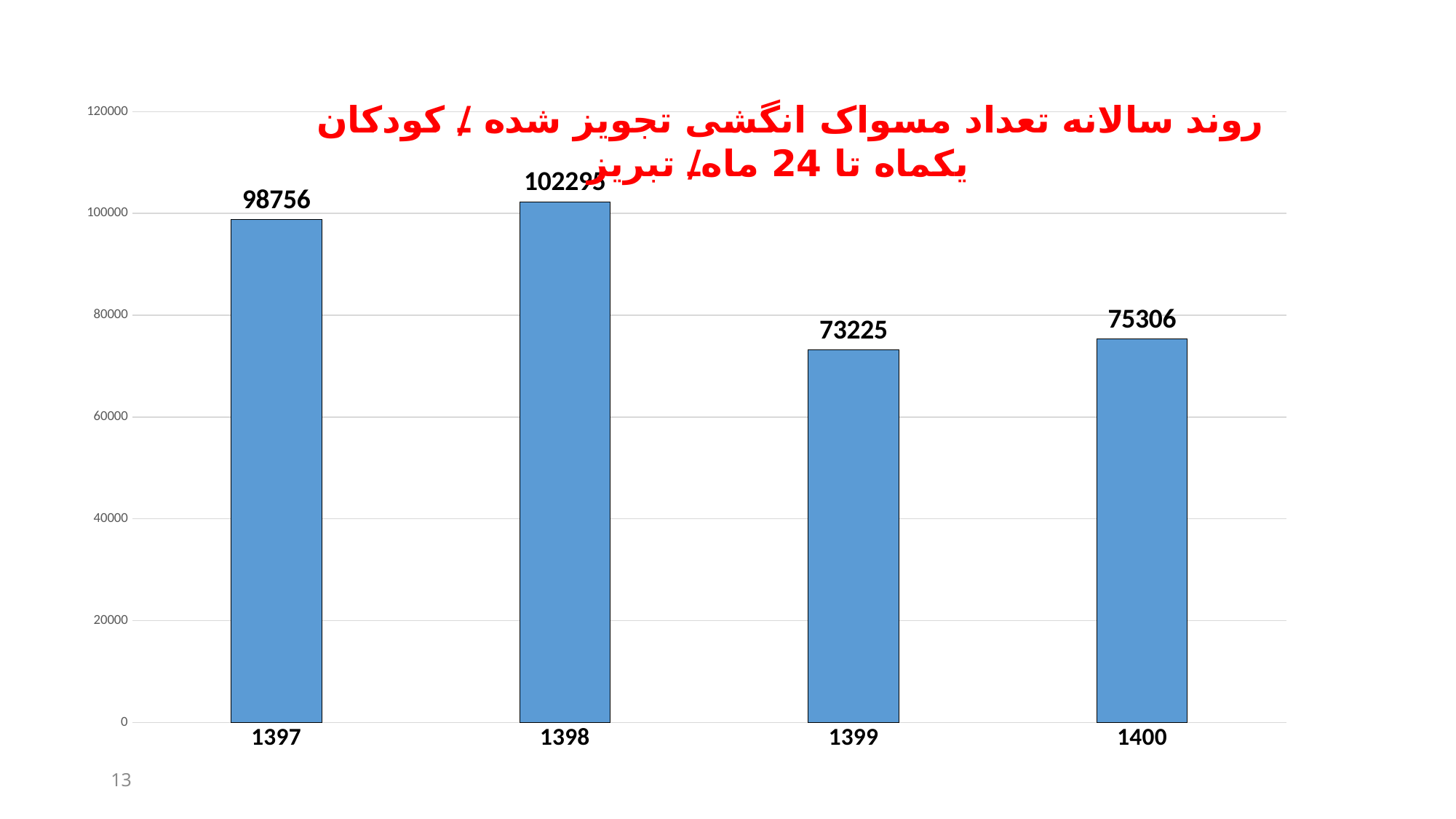
Is the value for 1399 greater or less than 80000? less What is the value for 1397? 98756 Which year has the lowest value? 1399 What is the value for 1399? 73225 What kind of chart is shown on the slide? bar chart Which year has the highest value? 1398 What is the difference between the values for 1400 and 1399? 2081 What is the value for 1400? 75306 Which is larger, the value for 1397 or the value for 1400? 1397 What is the difference between the values for 1397 and 1399? 25531 What colour are the bars in the chart? blue How many years are shown on the x axis? 4